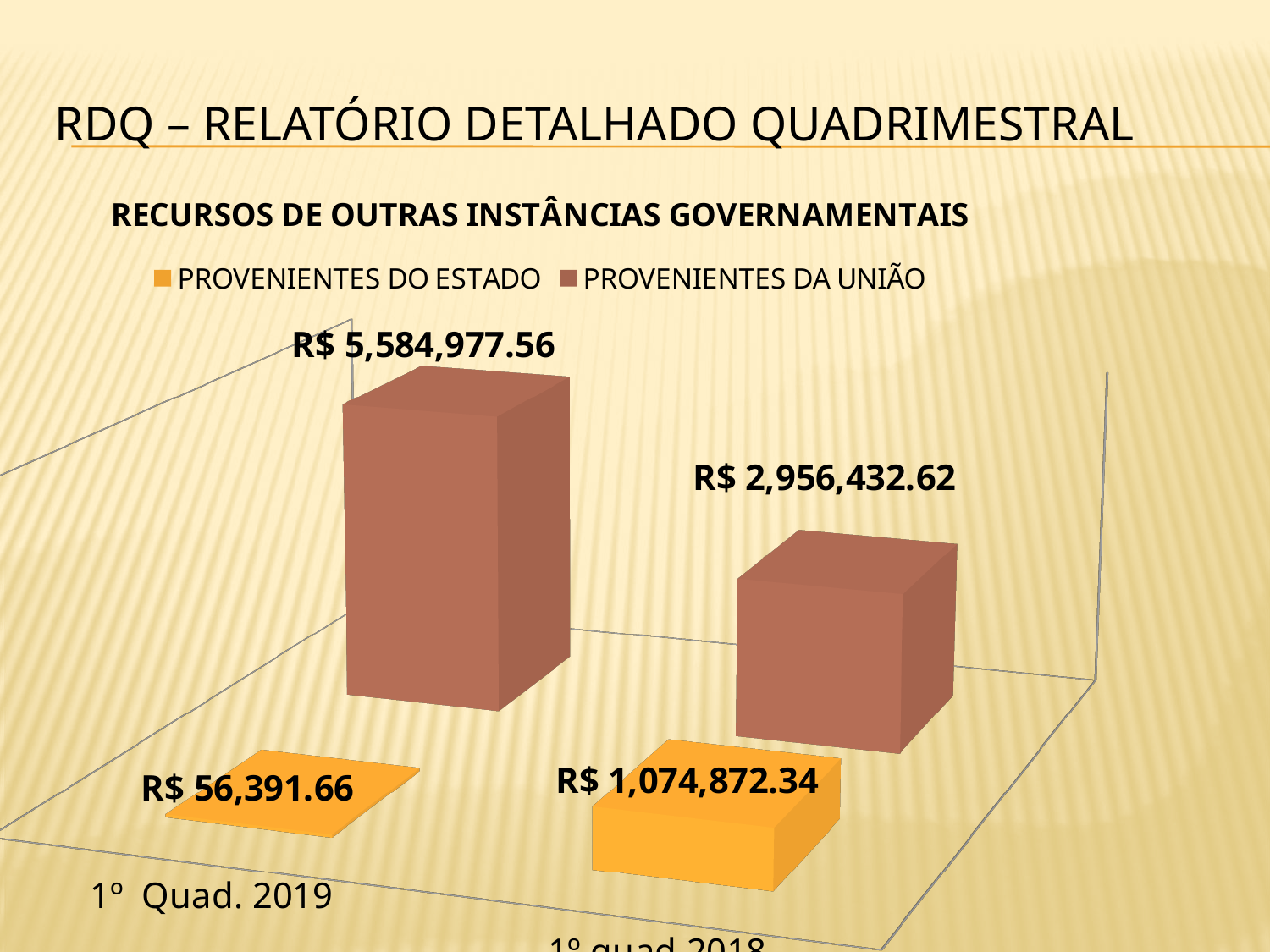
What is the difference between the PROVENIENTES DO ESTADO values for 1º quad 2018 and 1º Quad. 2019? R$ 1,018,480.68 What is the value for PROVENIENTES DA UNIÃO in 1º quad 2018? R$ 2,956,432.62 How many series does the legend list? 2 What is the difference between the PROVENIENTES DA UNIÃO values for 1º Quad. 2019 and 1º quad 2018? R$ 2,628,544.94 What kind of chart is shown on the slide? Bar chart Which bar has the lowest value on the chart? PROVENIENTES DO ESTADO, 1º Quad. 2019 What is the title of the chart? RECURSOS DE OUTRAS INSTÂNCIAS GOVERNAMENTAIS Which is larger: PROVENIENTES DO ESTADO in 1º Quad. 2019 or in 1º quad 2018? 1º quad 2018 What is the value for PROVENIENTES DO ESTADO in 1º Quad. 2019? R$ 56,391.66 Which bar has the highest value on the chart? PROVENIENTES DA UNIÃO, 1º Quad. 2019 What is the value for PROVENIENTES DO ESTADO in 1º quad 2018? R$ 1,074,872.34 What is the value for PROVENIENTES DA UNIÃO in 1º Quad. 2019? R$ 5,584,977.56